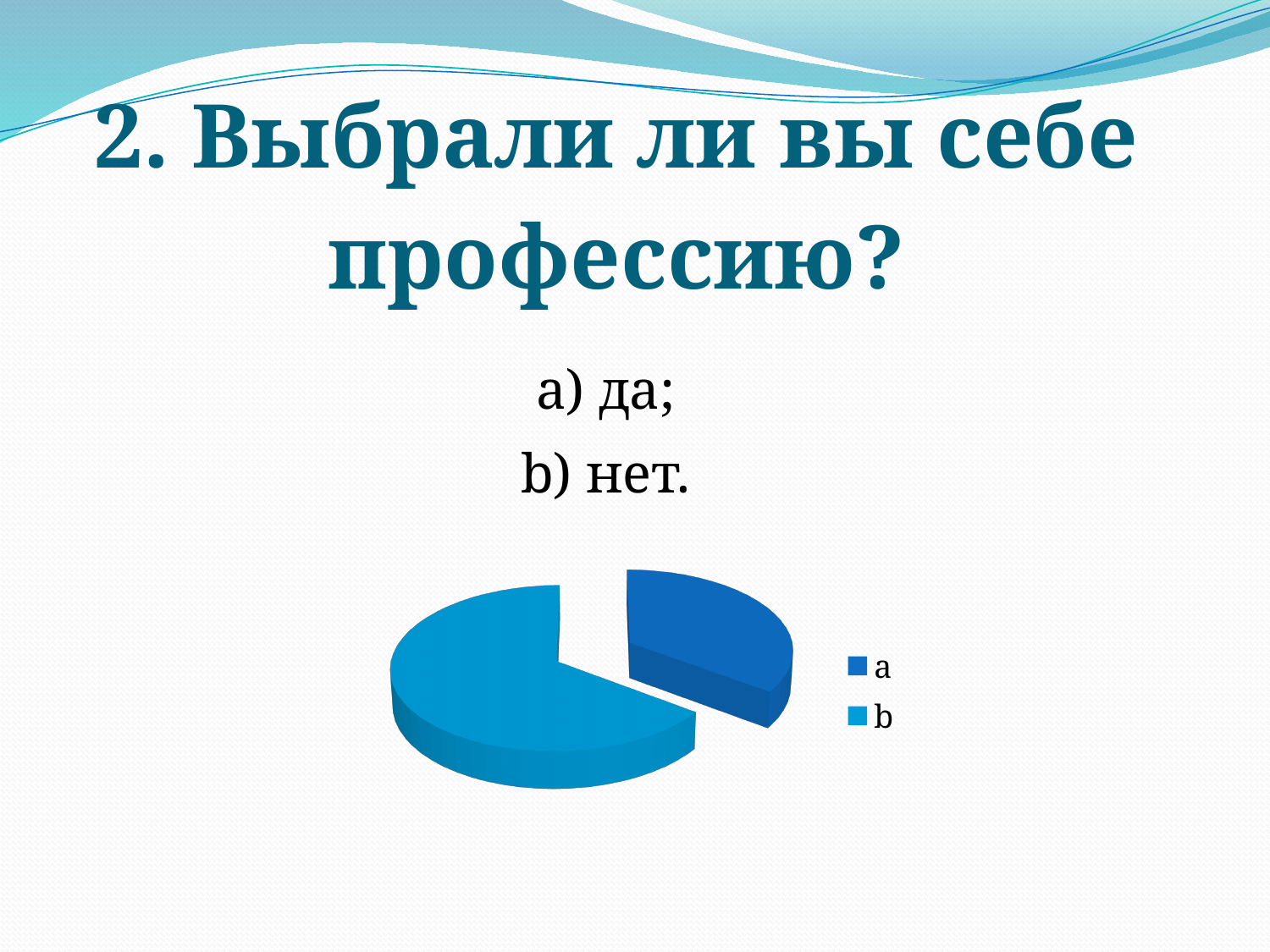
Which slice of the pie chart is the smallest? a How many entries does the legend of the pie chart list? 2 Is the share of slice a in the pie chart greater or less than half of the pie? less How many slices does the pie chart have? 2 Which slice of the pie chart is pulled out (exploded) from the rest of the pie? a Is the share of slice b in the pie chart greater or less than half of the pie? greater What are the legend entries of the pie chart? a, b What kind of chart is shown on the slide? pie chart Which slice of the pie chart is the largest? b In the pie chart, which slice is larger, a or b? b